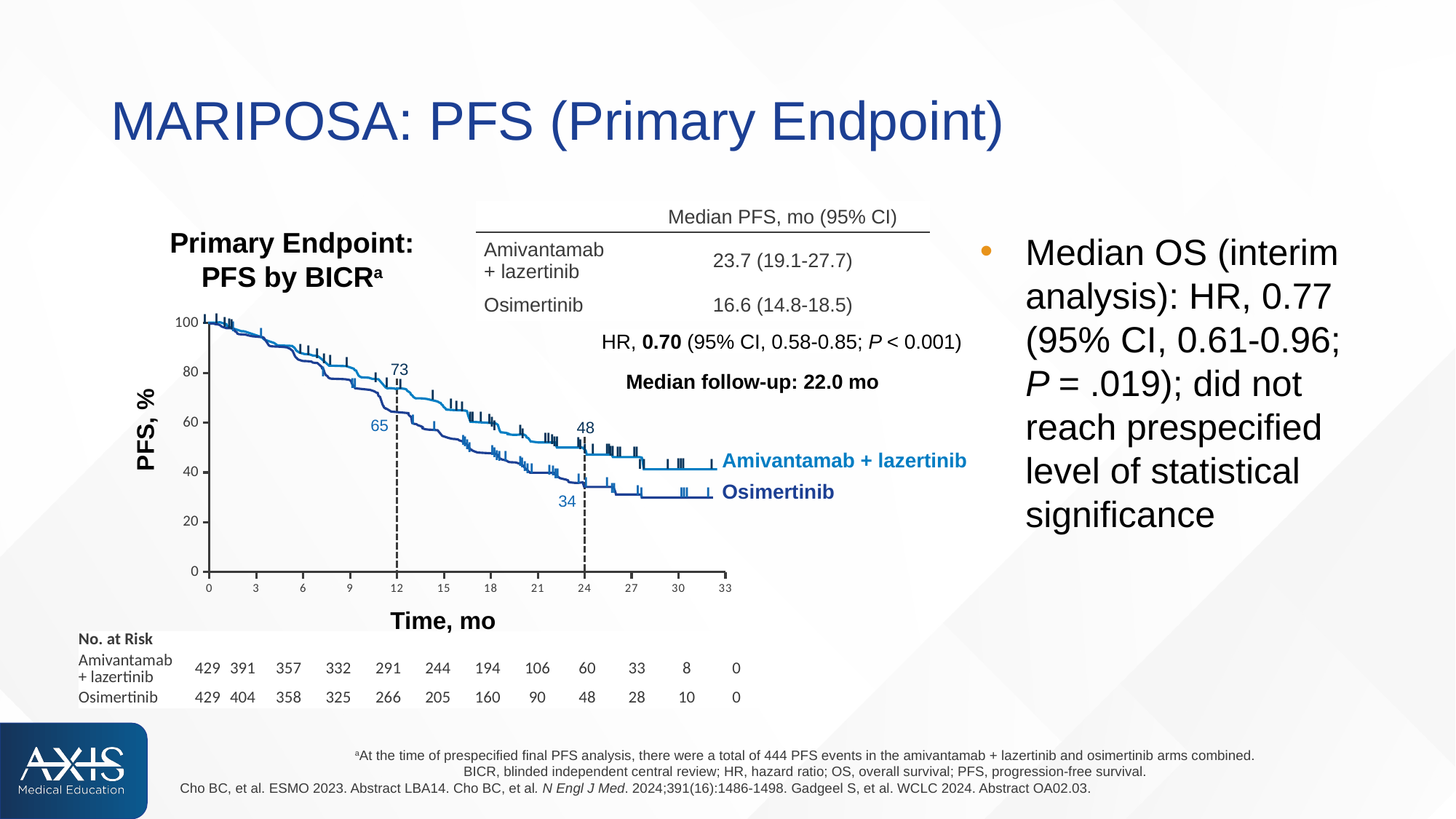
What is the PFS rate for amivantamab + lazertinib at 24 months? 48 What is the PFS rate for osimertinib at 12 months? 65 Do the PFS curves rise or fall as time increases? Fall What is the median PFS for osimertinib? 16.6 (14.8-18.5) What is the PFS rate for osimertinib at 24 months? 34 What is the difference in PFS rate between amivantamab + lazertinib and osimertinib at 24 months? 14 Which arm has the higher PFS rate at 12 months, amivantamab + lazertinib or osimertinib? Amivantamab + lazertinib How many series are plotted on the PFS chart? 2 What is the PFS rate for amivantamab + lazertinib at 12 months? 73 What is the label of the y axis of the chart? PFS, % What is the median PFS for amivantamab + lazertinib? 23.7 (19.1-27.7) How many patients were at risk in the osimertinib arm at 18 months? 160